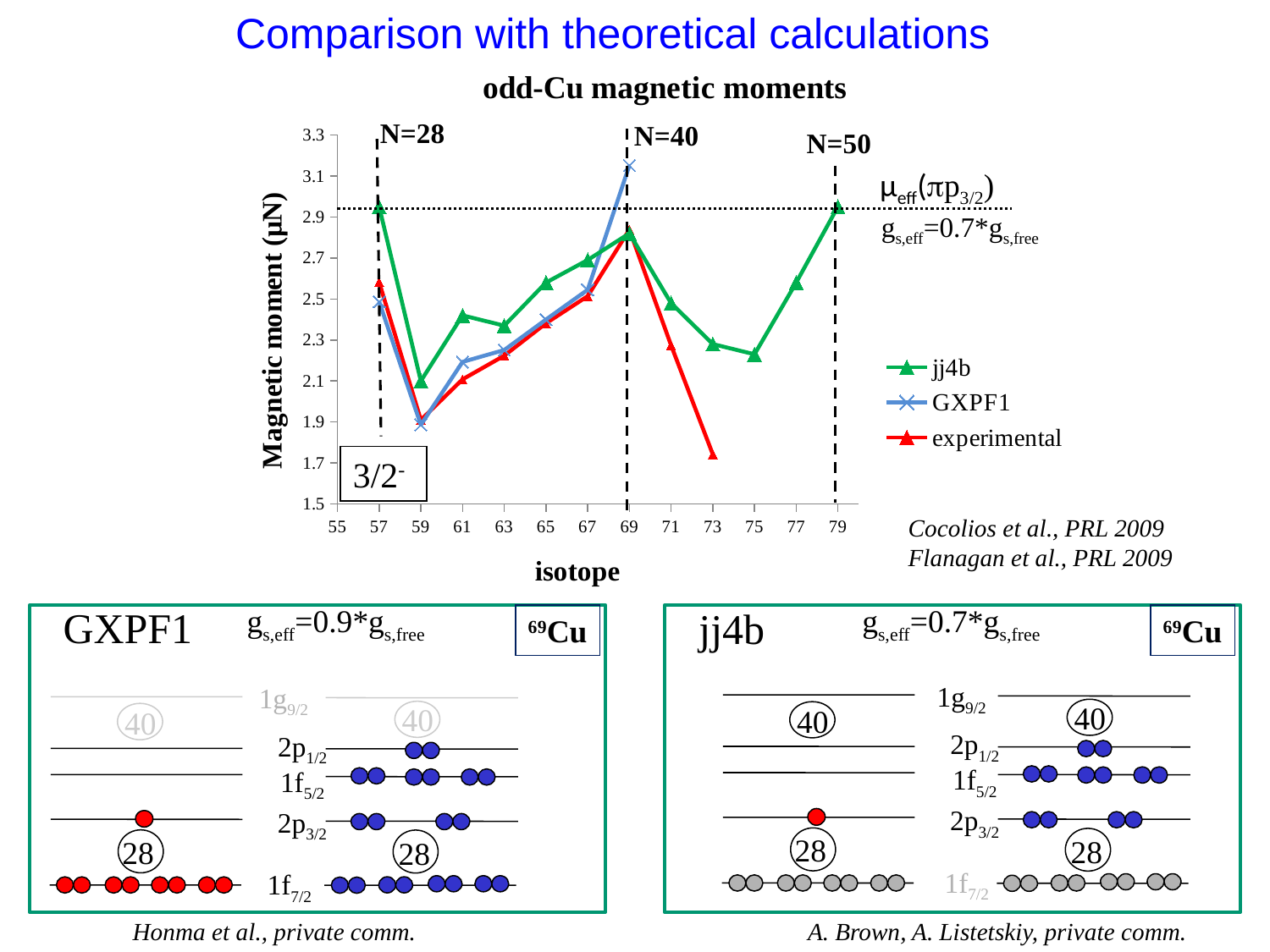
In the 'odd-Cu magnetic moments' chart, is the GXPF1 value at isotope 69 greater or less than 2.9? greater In the 'odd-Cu magnetic moments' chart, is the experimental value at isotope 73 greater or less than 1.9? less In the 'odd-Cu magnetic moments' chart, at isotope 69, which is larger: the GXPF1 value or the experimental value? GXPF1 In the 'odd-Cu magnetic moments' chart, at which isotope does the experimental series reach its lowest value? 73 How many series does the legend of the 'odd-Cu magnetic moments' chart list? 3 What kind of chart is shown under the title 'odd-Cu magnetic moments'? line chart What are the three series named in the legend of the 'odd-Cu magnetic moments' chart? jj4b, GXPF1, experimental What is the title of the y axis of the 'odd-Cu magnetic moments' chart? Magnetic moment (μN) In the 'odd-Cu magnetic moments' chart, is the jj4b value at isotope 59 greater or less than 2.3? less How many data points does the GXPF1 series have in the 'odd-Cu magnetic moments' chart? 7 In the 'odd-Cu magnetic moments' chart, does the experimental series rise or fall from isotope 69 to isotope 73? fall In the 'odd-Cu magnetic moments' chart, at which isotope does the GXPF1 series reach its highest value? 69